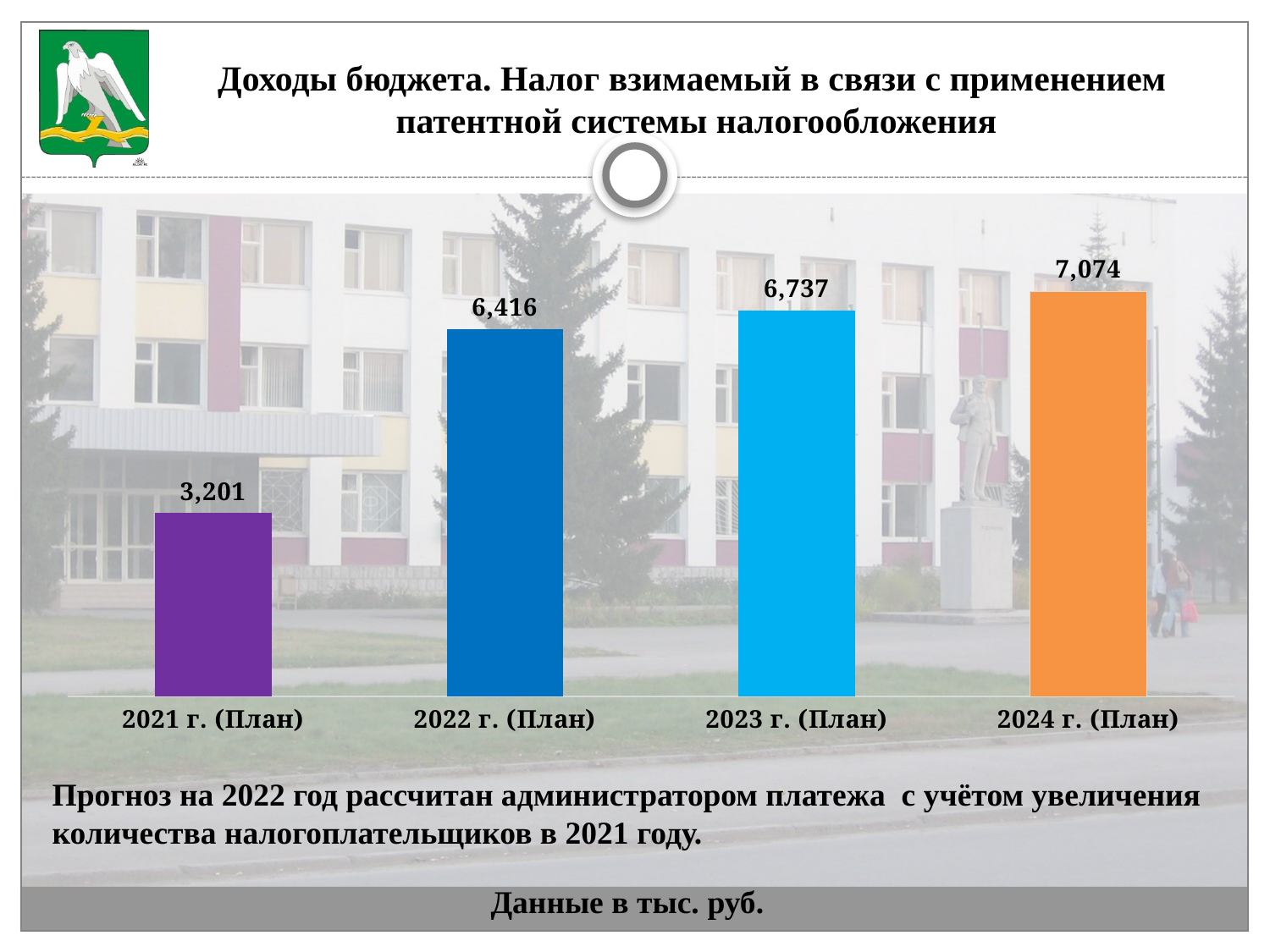
What kind of chart is shown on the slide? Bar chart Which year has the lowest value? 2021 г. (План) Do the values rise or fall from 2021 г. (План) to 2024 г. (План)? Rise What is the value for 2022 г. (План)? 6,416 What is the value for 2023 г. (План)? 6,737 Which is larger, the value for 2023 г. (План) or 2022 г. (План)? 2023 г. (План) What is the value for 2024 г. (План)? 7,074 Which year has the highest value? 2024 г. (План) What is the value for 2021 г. (План)? 3,201 What is the difference between the values for 2024 г. (План) and 2023 г. (План)? 337 What is the difference between the values for 2022 г. (План) and 2021 г. (План)? 3,215 How many categories are shown in the chart? 4